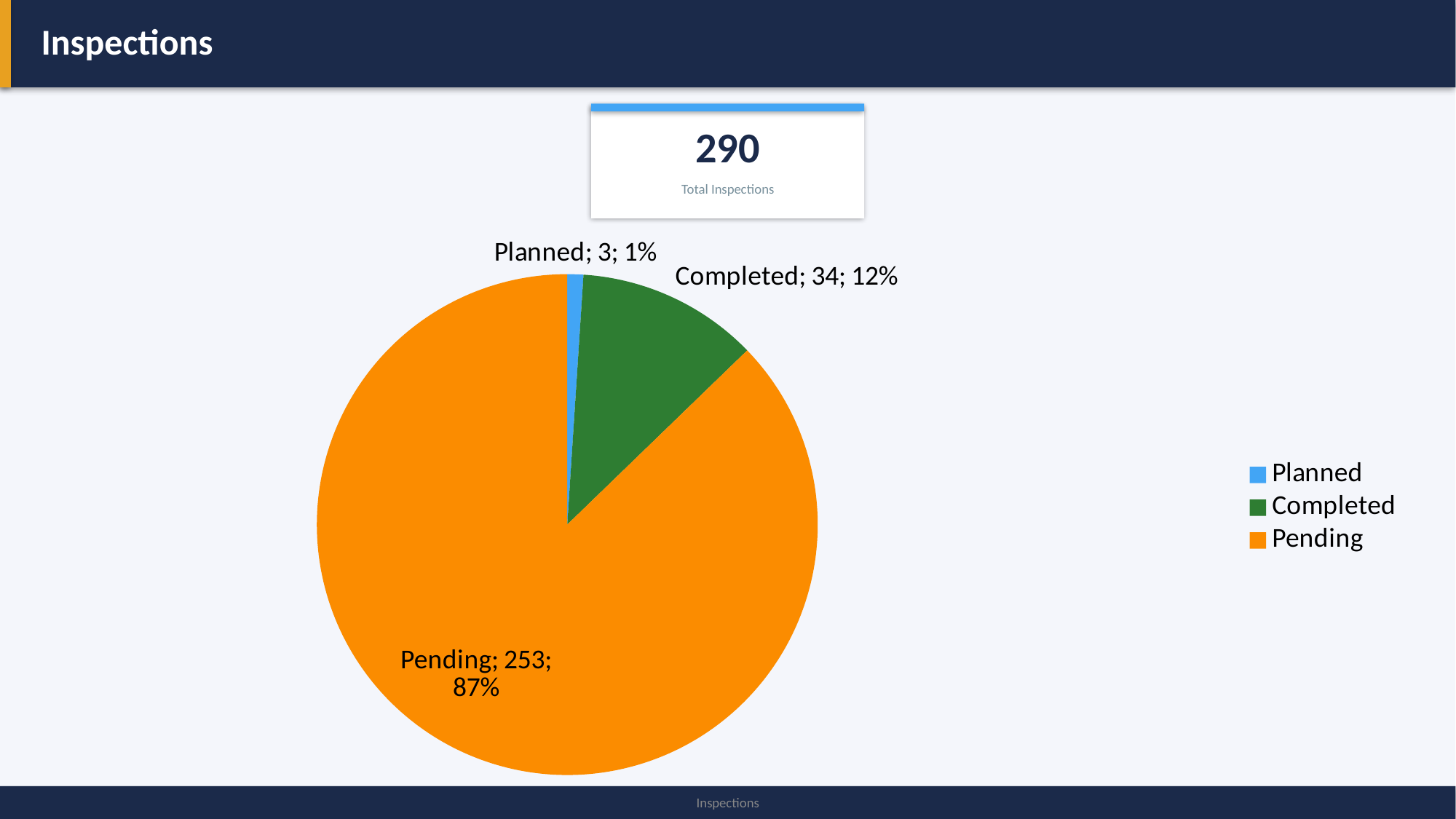
Which category has the largest slice of the pie chart? Pending Which category has the smallest slice of the pie chart? Planned What is the difference between the Pending and Completed values? 219 How many categories does the pie chart show? 3 How many inspections are Completed according to the pie chart? 34 What kind of chart is shown on the slide? pie chart How many inspections are Planned according to the pie chart? 3 What share of the pie does the Completed slice represent? 12% How many inspections are Pending according to the pie chart? 253 Which is larger, the Completed value or the Planned value? Completed What share of the pie does the Pending slice represent? 87% What colour is the Pending slice in the pie chart? orange